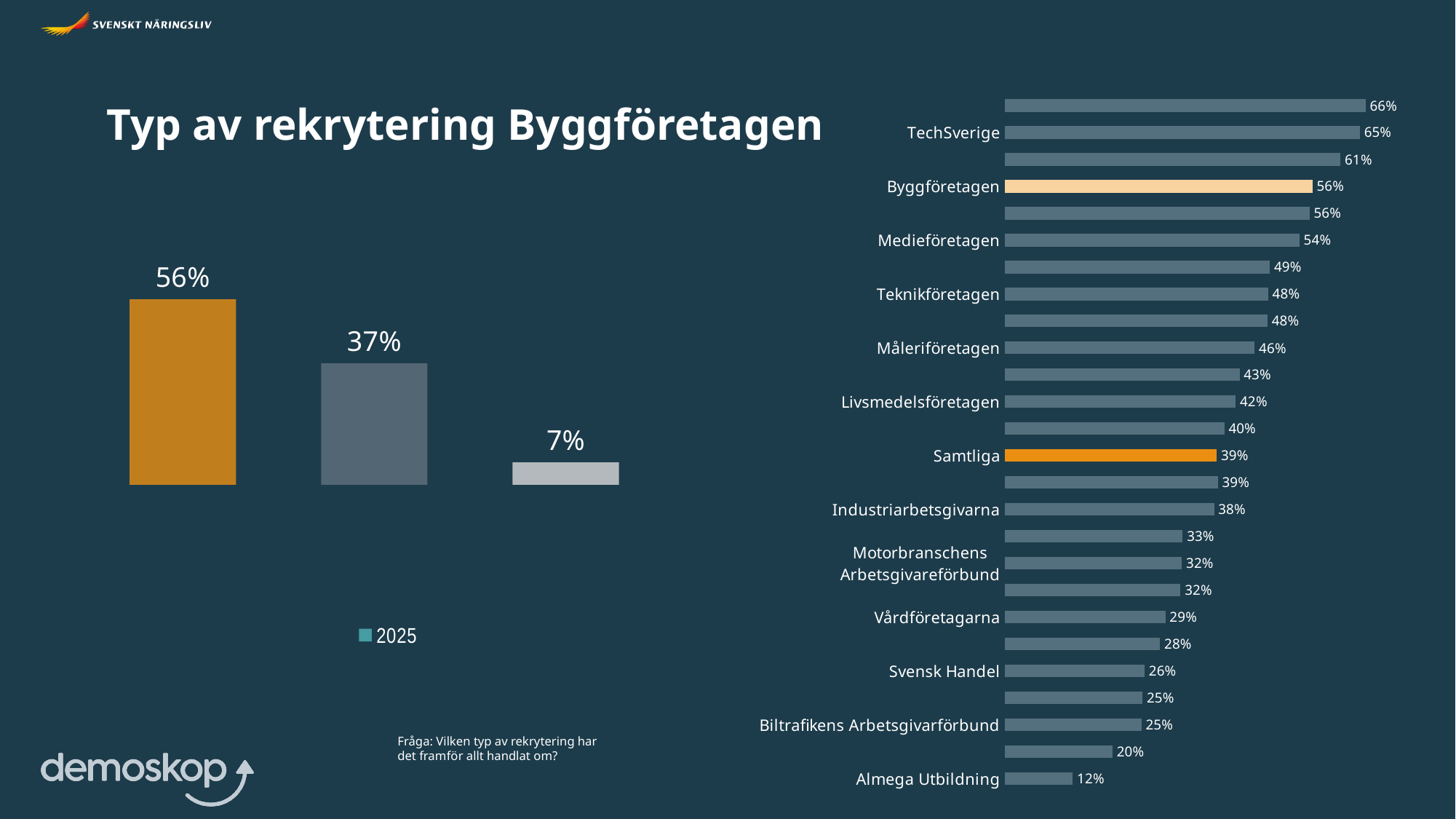
On the right-hand chart, which labelled category has the lowest value? Almega Utbildning On the right-hand chart, what is the difference between Byggföretagen and Samtliga? 17% What kind of chart is the right-hand chart? bar chart On the right-hand chart, what is the difference between Svensk Handel and Vårdföretagarna? 3% On the right-hand chart, what is the value for TechSverige? 65% On the right-hand chart, what is the value for Samtliga? 39% On the right-hand chart, what is the value for Almega Utbildning? 12% On the right-hand chart, what is the highest value shown on any bar? 66% On the left-hand chart titled 'Typ av rekrytering Byggföretagen', what is the value of the tallest bar? 56% How many bars are in the left-hand chart titled 'Typ av rekrytering Byggföretagen'? 3 On the right-hand chart, what is the value for Byggföretagen? 56% On the right-hand chart, which is larger, Medieföretagen or Teknikföretagen? Medieföretagen